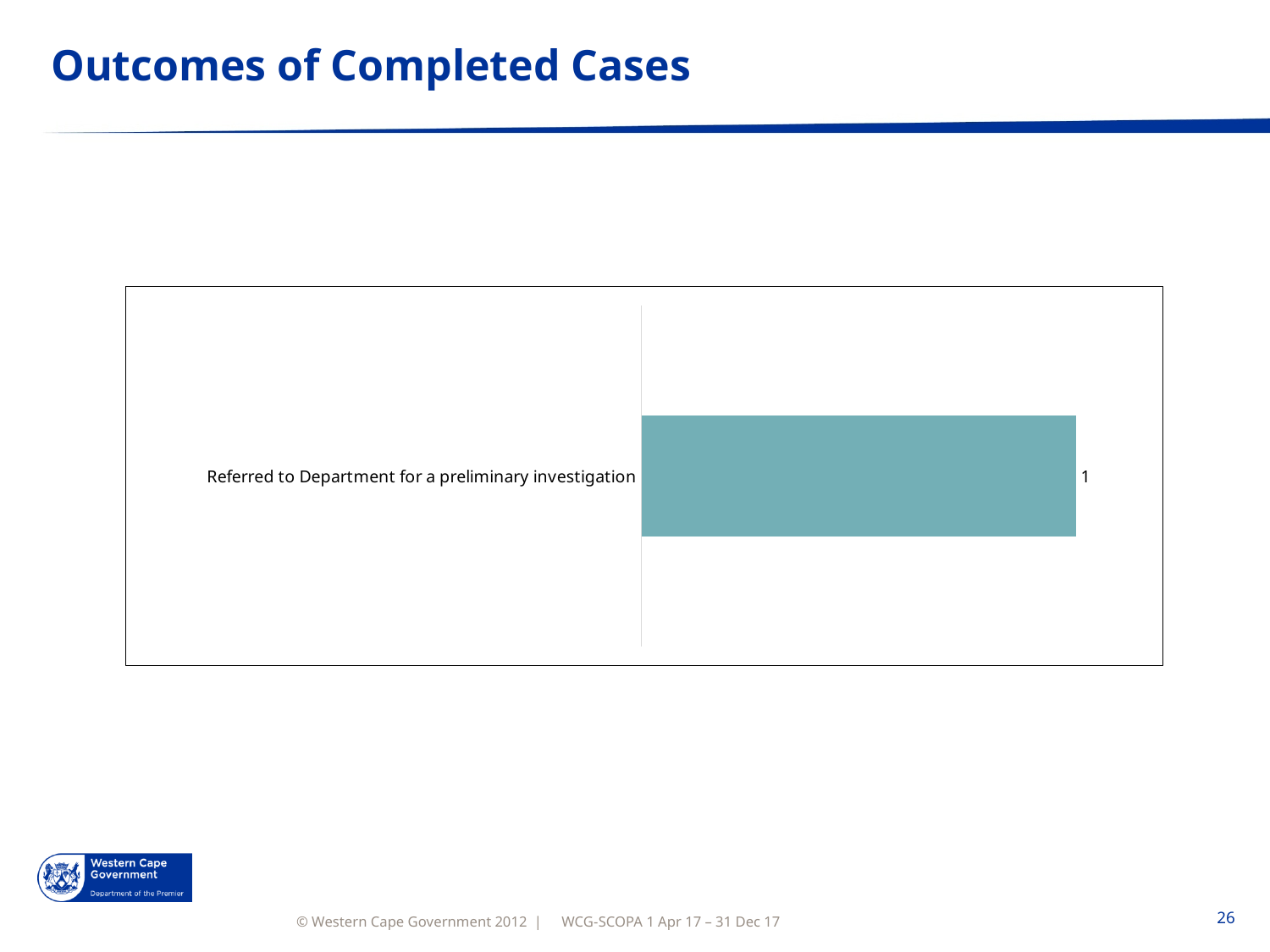
What kind of chart is shown on the slide? bar chart What is the label of the only category in the chart? Referred to Department for a preliminary investigation What is the value for "Referred to Department for a preliminary investigation"? 1 How many categories does the chart show? 1 What is the title of the slide containing the chart? Outcomes of Completed Cases Are the bars in the chart horizontal or vertical? horizontal